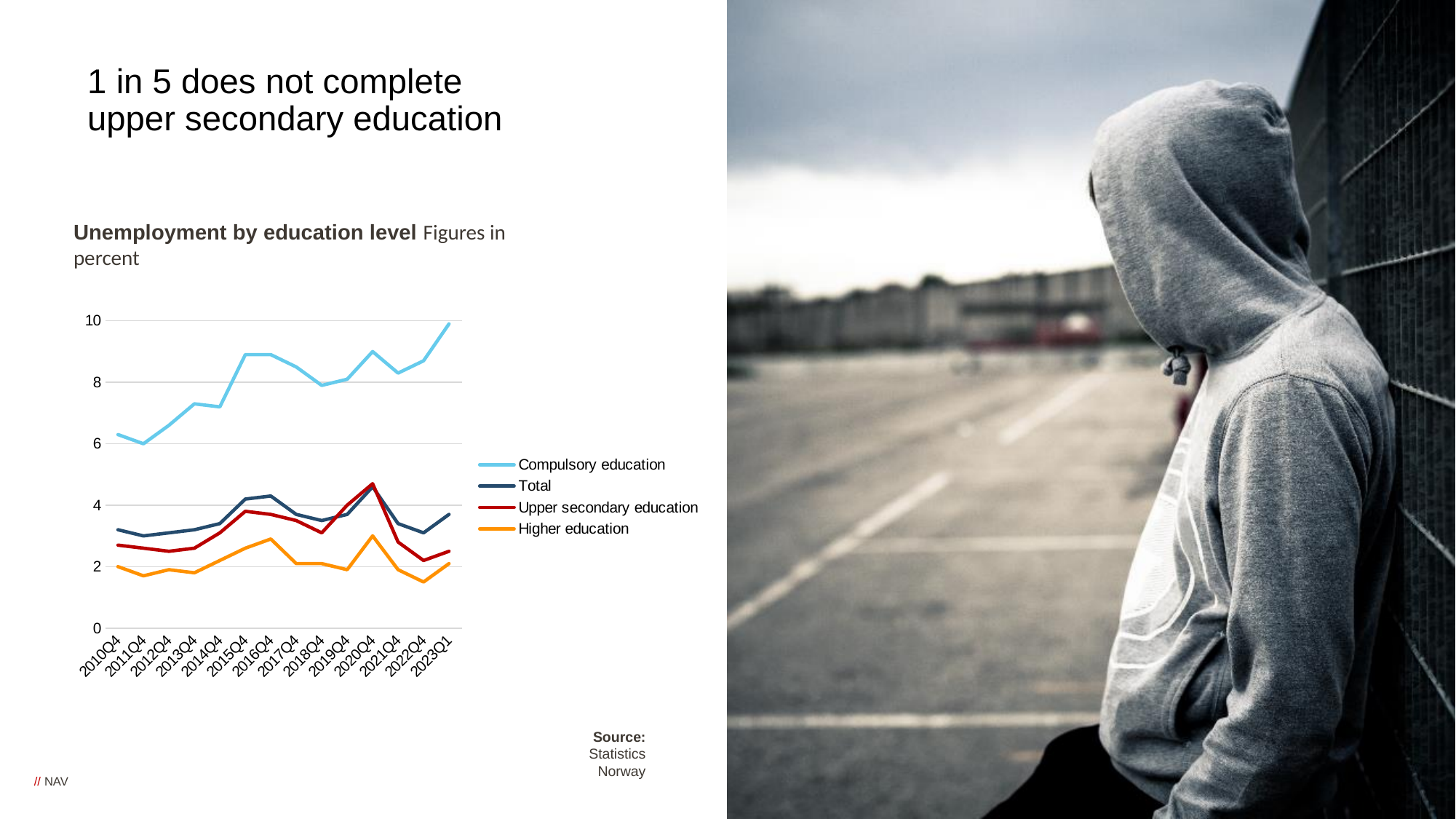
Which series has the highest unemployment rate across the whole period? Compulsory education Does the Compulsory education line rise or fall overall from 2010Q4 to 2023Q1? Rises How many series does the legend list? 4 Is the value for Compulsory education at 2023Q1 greater or less than 8? greater Is the value for Higher education at 2022Q4 greater or less than 2? less What kind of chart is shown on the slide? Line chart Is the value for Upper secondary education at 2020Q4 greater or less than 4? greater At which time point does the Compulsory education line reach its highest value? 2023Q1 Which series has the lowest unemployment rate across the whole period? Higher education How many time points are shown on the x axis? 14 At 2015Q4, which is larger: Total or Upper secondary education? Total